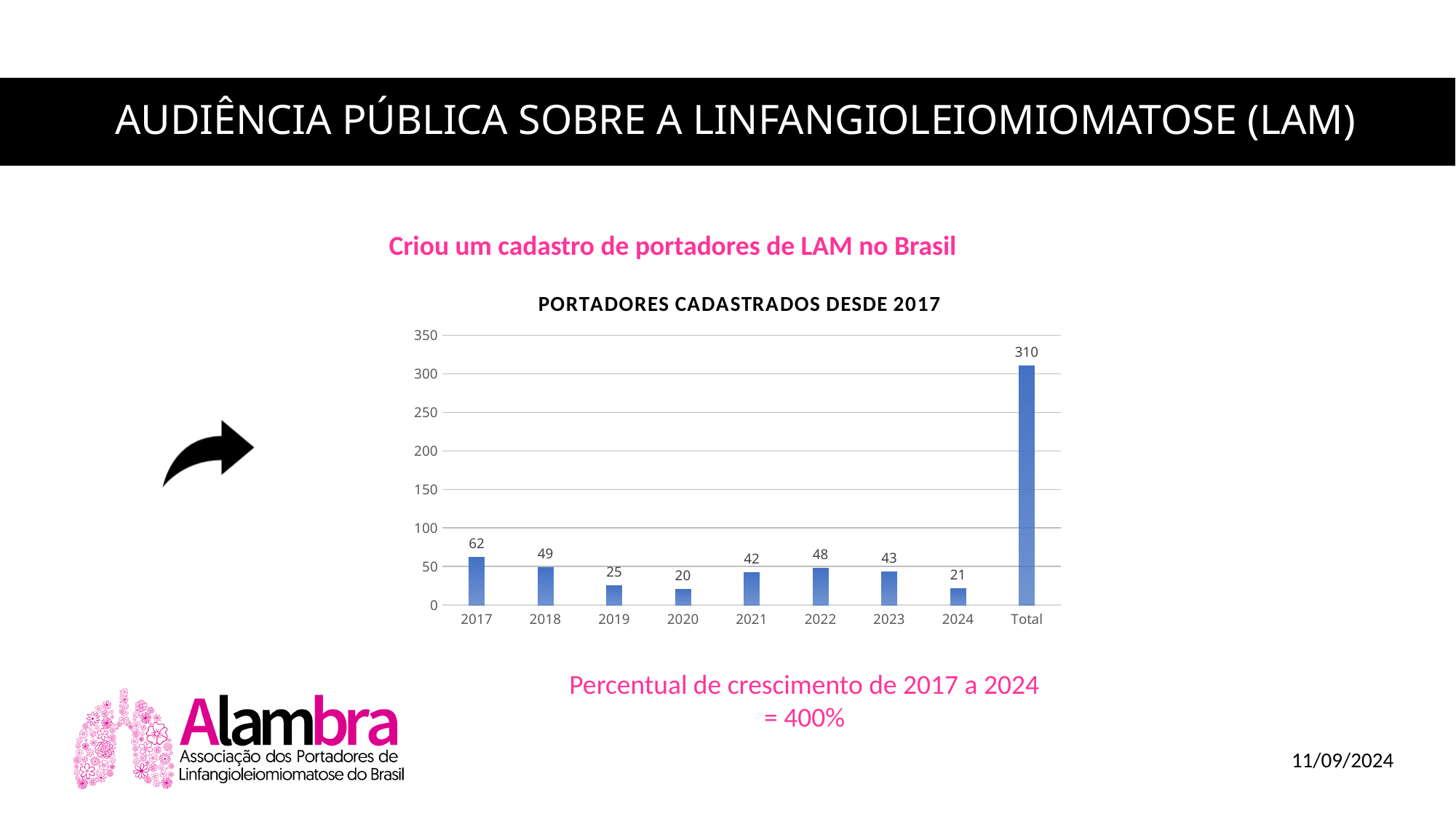
What is the value shown for Total? 310 How many categories are shown on the x axis? 9 Which year from 2017 to 2024 has the lowest value? 2020 Do the values rise or fall from 2017 to 2020? fall Is the value for Total greater or less than 300? greater What is the value for 2017? 62 Which year from 2017 to 2024 has the highest value? 2017 What is the difference between the values for 2017 and 2024? 41 What is the value for 2020? 20 What is the title of the chart? PORTADORES CADASTRADOS DESDE 2017 What kind of chart is this? bar chart Which is larger, the value for 2022 or the value for 2023? 2022